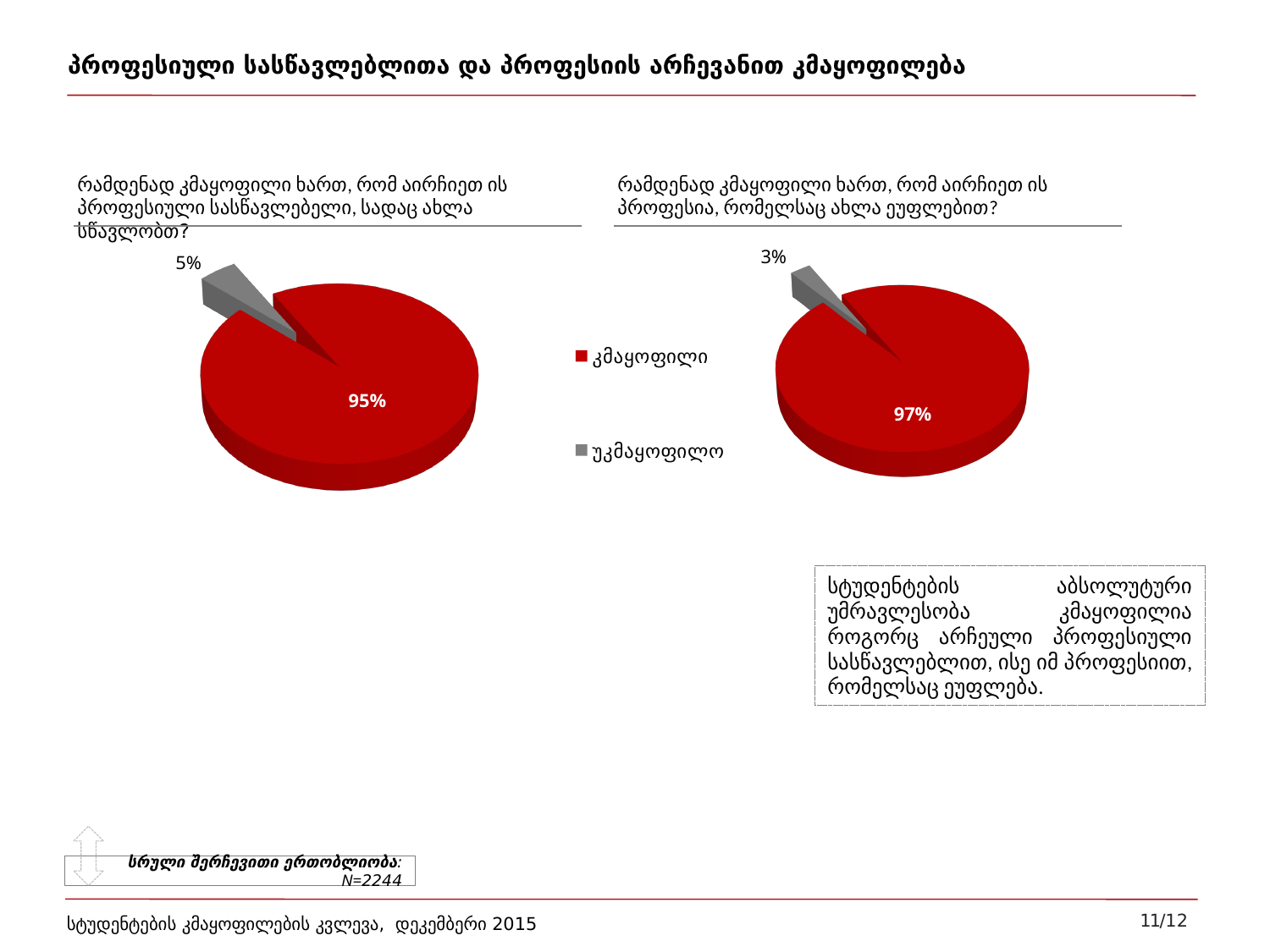
In the left pie chart, what share is labelled for the red slice (კმაყოფილი)? 95% Which chart shows a larger უკმაყოფილო share, the left pie chart or the right pie chart? the left pie chart In the right pie chart, what share is labelled for the red slice (კმაყოფილი)? 97% How many slices does the left pie chart have? 2 In the left pie chart, which category has the largest slice? კმაყოფილი In the right pie chart, what share is labelled for the grey slice (უკმაყოფილო)? 3% In the right pie chart, which category has the smallest slice? უკმაყოფილო In the left pie chart, what share is labelled for the grey slice (უკმაყოფილო)? 5% How many entries does the legend between the two charts list? 2 Which colour represents კმაყოფილი in the legend? red What is the difference between the კმაყოფილი share in the right pie chart and the კმაყოფილი share in the left pie chart? 2% What type of chart is the right chart on the slide? pie chart